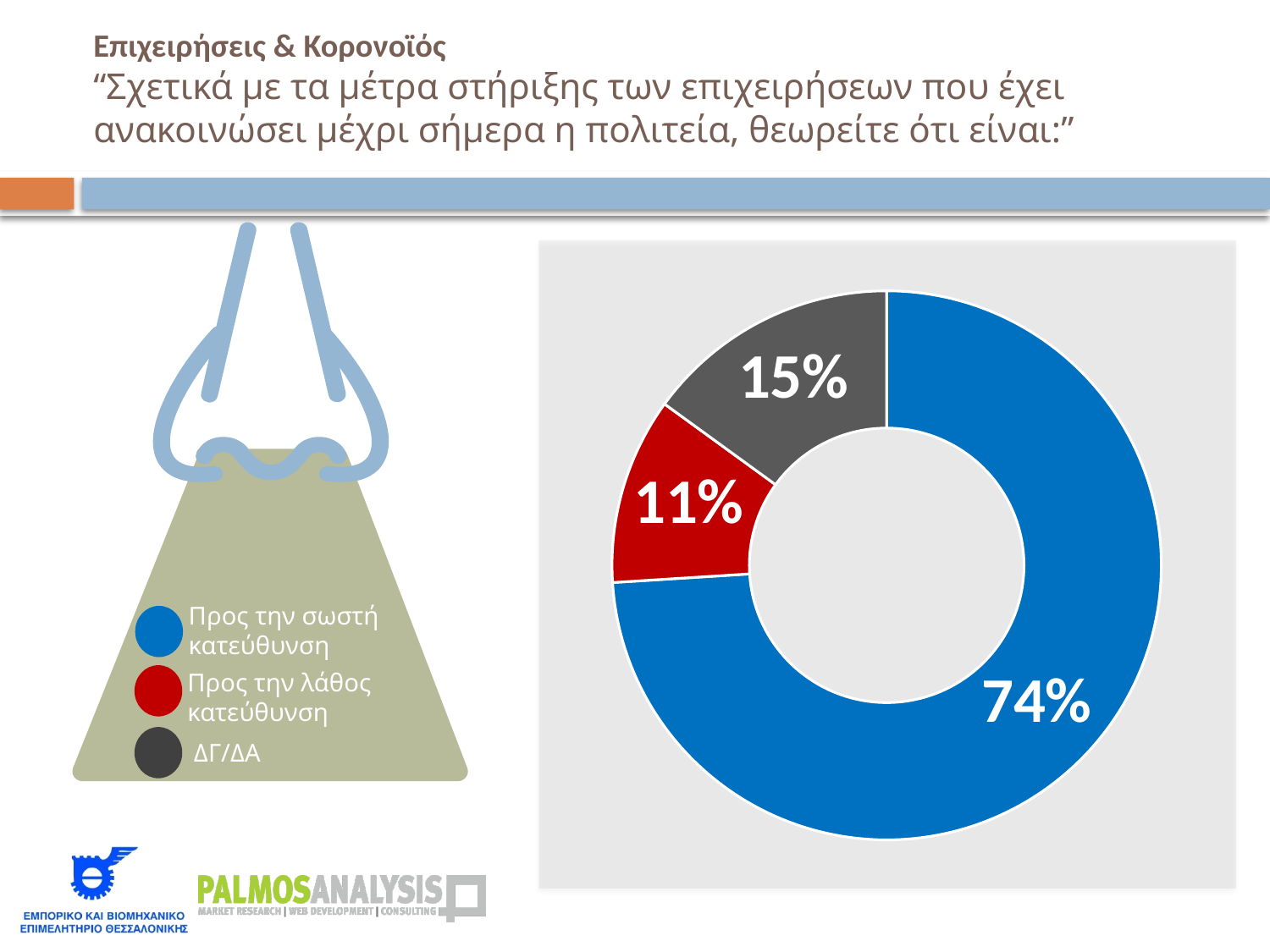
What colour represents "ΔΓ/ΔΑ" in the chart? Dark grey What kind of chart is shown on the slide? Doughnut (pie) chart How many categories are shown in the chart? 3 What share of respondents answered "Προς την λάθος κατεύθυνση"? 11% Which response has the largest share in the chart? Προς την σωστή κατεύθυνση What is the difference in percentage points between "ΔΓ/ΔΑ" and "Προς την λάθος κατεύθυνση"? 4 percentage points What share of respondents answered "Προς την σωστή κατεύθυνση"? 74% Which is larger: the share for "ΔΓ/ΔΑ" or the share for "Προς την λάθος κατεύθυνση"? ΔΓ/ΔΑ What colour represents "Προς την λάθος κατεύθυνση" in the chart? Red What share of respondents answered "ΔΓ/ΔΑ"? 15% Which response has the smallest share in the chart? Προς την λάθος κατεύθυνση What is the difference in percentage points between "Προς την σωστή κατεύθυνση" and "Προς την λάθος κατεύθυνση"? 63 percentage points